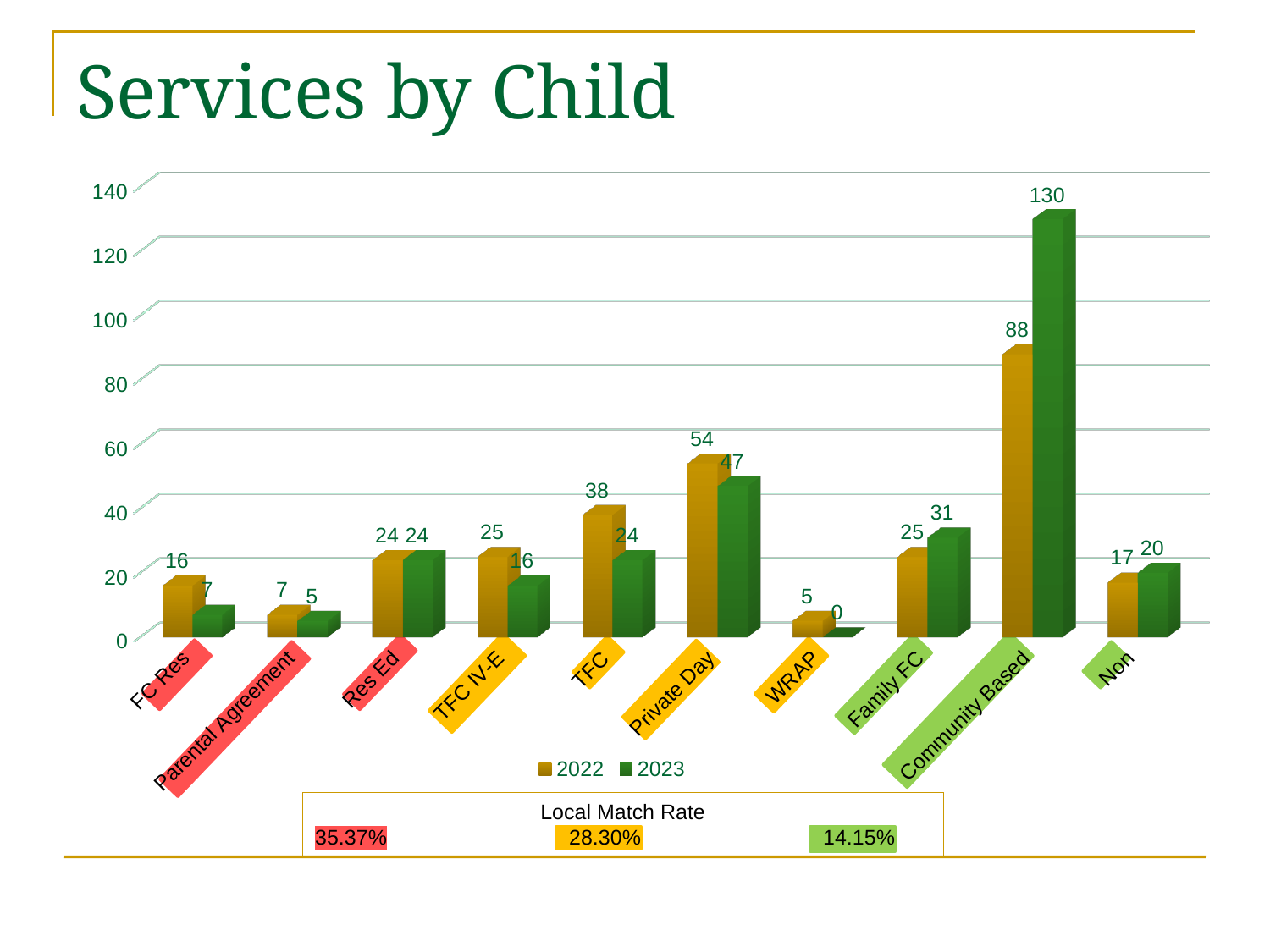
What is the 2023 value for Community Based? 130 What is the title of the chart? Services by Child How many categories are shown on the x axis? 10 What kind of chart is shown on the slide? Bar chart Is the 2022 value for Community Based greater or less than 80? greater Which is larger for TFC: the 2022 value or the 2023 value? 2022 What is the 2022 value for Private Day? 54 Which category has the lowest 2023 value? WRAP Which category has the highest 2022 value? Community Based How many series does the legend list? 2 What is the 2023 value for WRAP? 0 What is the difference between the 2023 and 2022 values for Community Based? 42